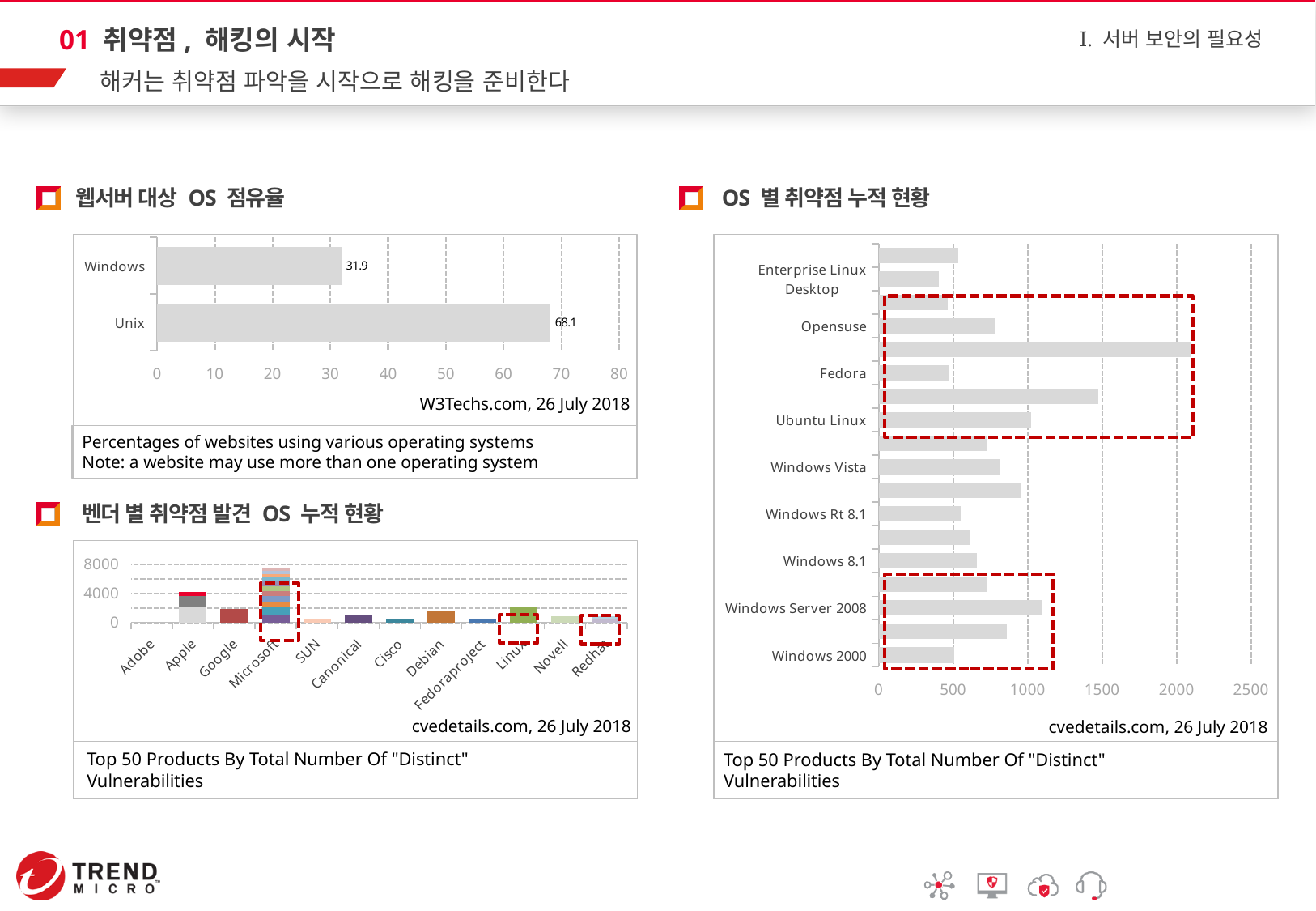
What kind of chart is the 'OS 별 취약점 누적 현황' chart? bar chart In the '벤더 별 취약점 발견 OS 누적 현황' chart, how many vendors are shown on the x axis? 12 In the 'OS 별 취약점 누적 현황' chart, is the value for Windows Vista greater or less than 500? greater In the '웹서버 대상 OS 점유율' chart, which category has the highest value? Unix In the '웹서버 대상 OS 점유율' chart, what is the value for Unix? 68.1 In the '웹서버 대상 OS 점유율' chart, what is the difference between the Unix and Windows values? 36.2 In the '웹서버 대상 OS 점유율' chart, what source is cited below the bars? W3Techs.com, 26 July 2018 In the 'OS 별 취약점 누적 현황' chart, is the value for Opensuse greater or less than 1000? less In the '벤더 별 취약점 발견 OS 누적 현황' chart, which vendor has the highest total? Microsoft In the '웹서버 대상 OS 점유율' chart, what is the value for Windows? 31.9 In the '벤더 별 취약점 발견 OS 누적 현황' chart, is the total for Microsoft greater or less than 4000? greater In the '웹서버 대상 OS 점유율' chart, how many categories are shown? 2